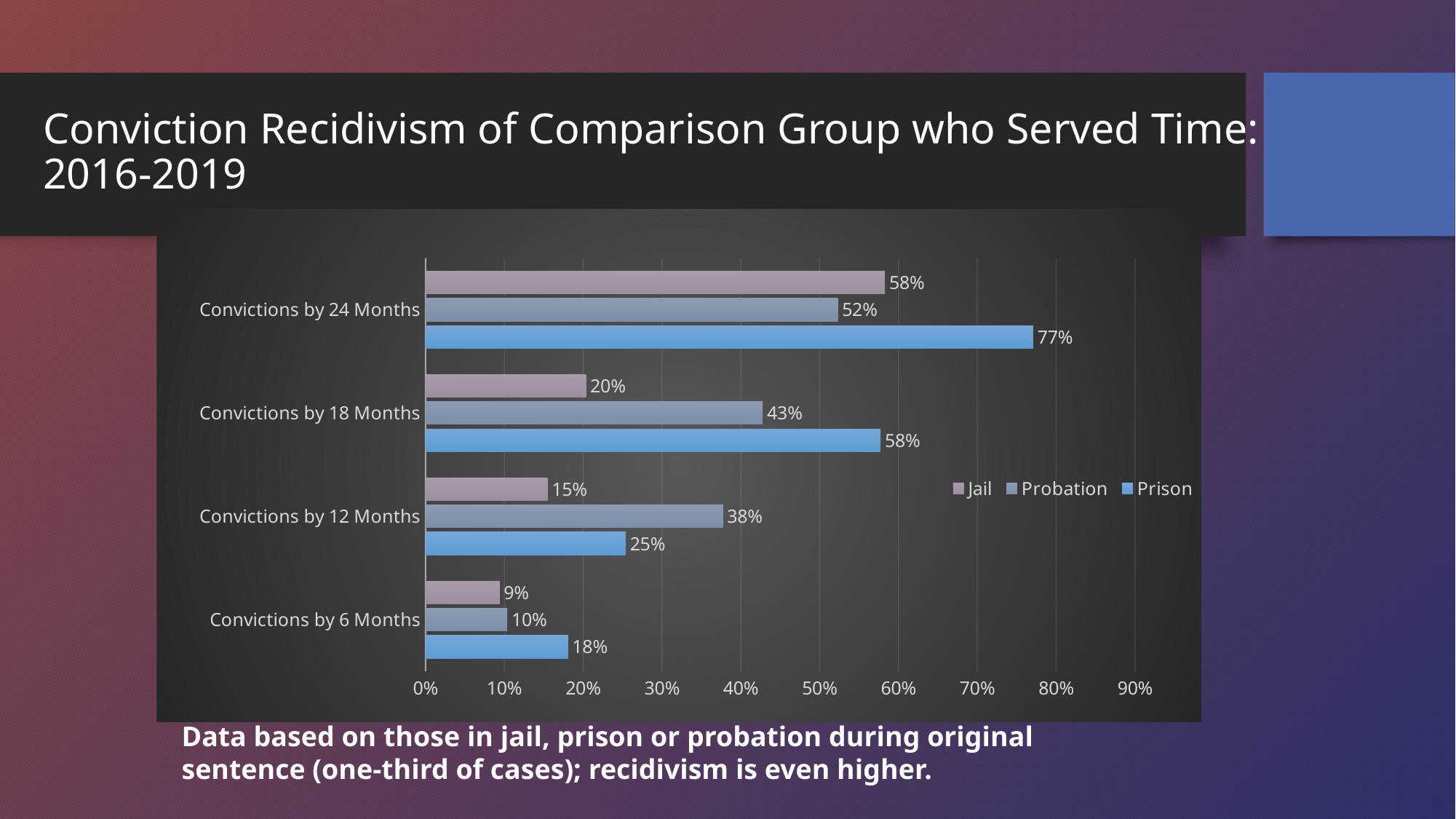
How many series does the legend list? 3 Which series has the lowest value for Convictions by 12 Months? Jail How many categories are shown on the chart? 4 What is the Jail value for Convictions by 18 Months? 20% Which is larger for Convictions by 12 Months: the Probation value or the Prison value? Probation What is the Jail value for Convictions by 6 Months? 9% What is the Prison value for Convictions by 24 Months? 77% Which series has the highest value for Convictions by 24 Months? Prison Do the Prison values rise or fall as the time period increases from 6 months to 24 months? Rise What is the difference between the Prison and Probation values for Convictions by 24 Months? 25% What kind of chart is shown on the slide? Bar chart What is the Probation value for Convictions by 12 Months? 38%